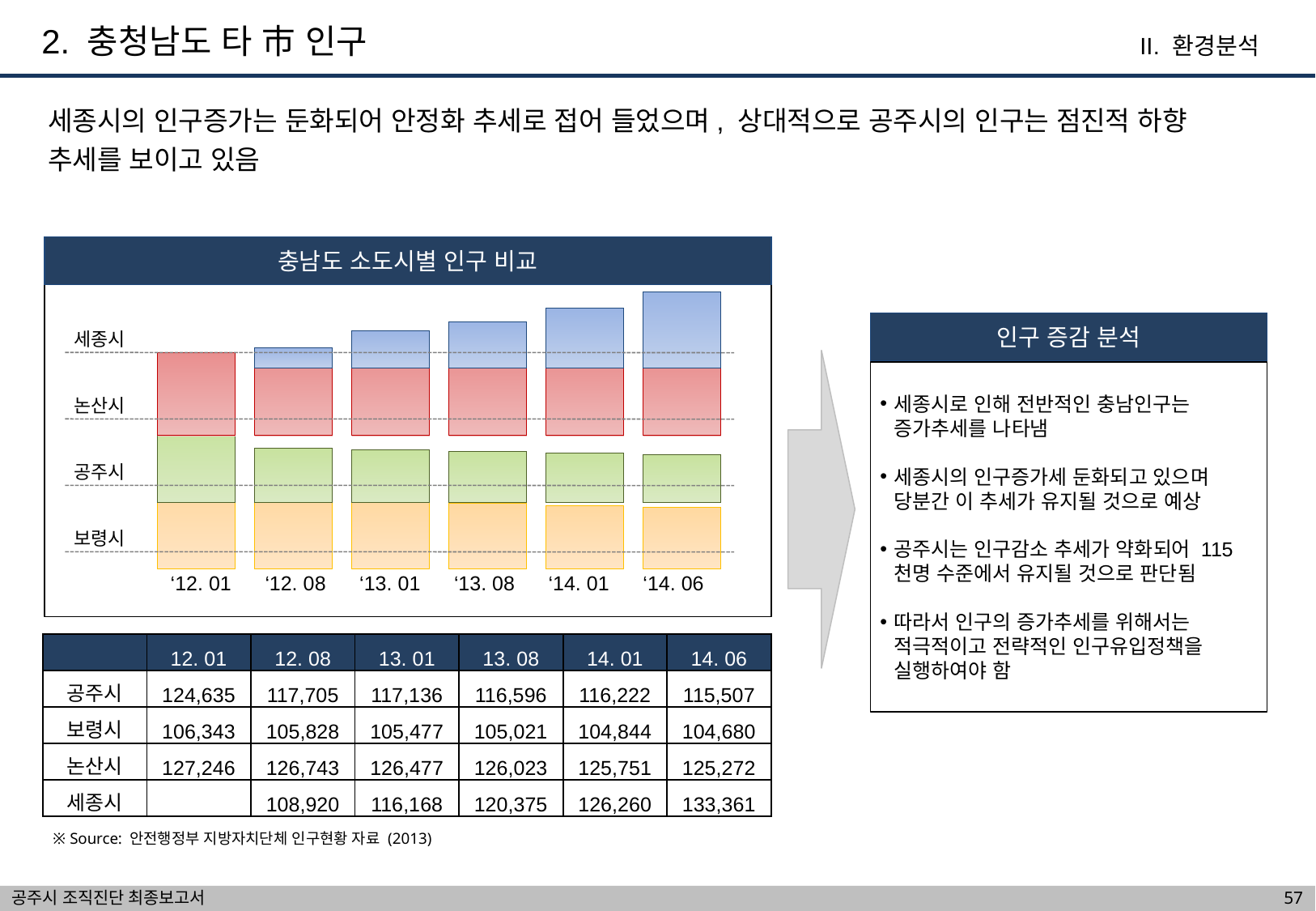
Which is larger at '13. 01, the population of 논산시 or 보령시? 논산시 How many time points are shown along the x axis of the chart? 6 What is the total population of the four cities at '14. 06? 478,820 Does the population of 세종시 rise or fall from '12. 08 to '14. 06? Rise Which city has the smallest population at '14. 06? 보령시 What is the population of 논산시 at '12. 01? 127,246 What kind of chart is shown under the title 충남도 소도시별 인구 비교? Stacked bar chart By how much did the population of 공주시 decrease from '12. 01 to '14. 06? 9,128 What is the population of 세종시 at '12. 08? 108,920 Which city has the largest population at '14. 06? 세종시 What is the population of 공주시 at '14. 06? 115,507 How many cities (series) are stacked in each bar of the chart? 4